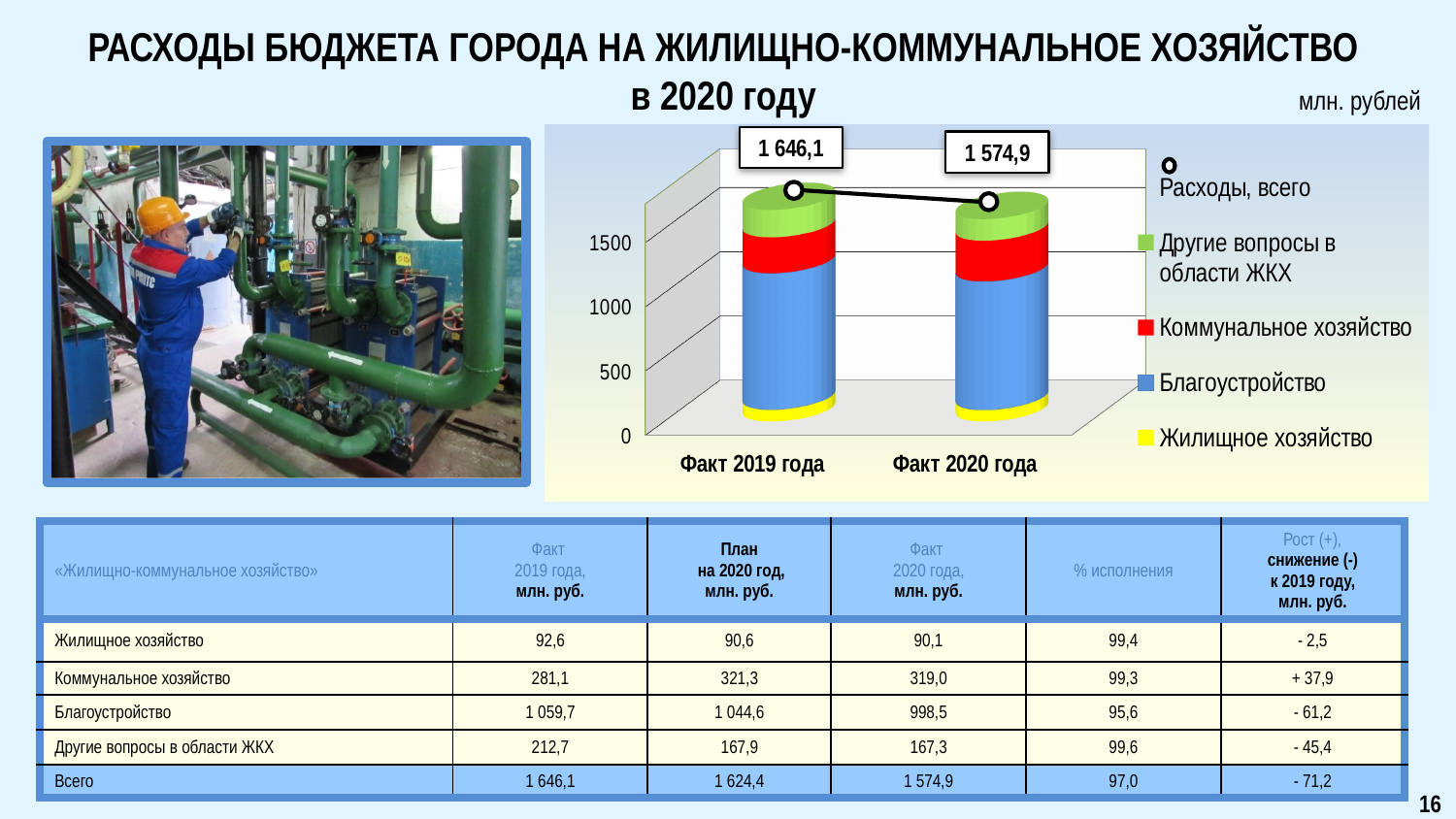
Which legend entry is shown in yellow? Жилищное хозяйство Do total expenditures rise or fall from Факт 2019 года to Факт 2020 года? fall Which colour represents Коммунальное хозяйство in the chart legend? red How many categories are shown on the x axis of the chart? 2 By how much does the total for Факт 2019 года exceed the total for Факт 2020 года? 71,2 What kind of chart is shown on the slide? bar chart Is the Благоустройство segment for Факт 2020 года greater or less than 500? greater What is the value of the 'Расходы, всего' data label for Факт 2019 года? 1 646,1 How many entries does the chart legend list? 5 What is the value of the 'Расходы, всего' data label for Факт 2020 года? 1 574,9 Which category has the higher total expenditure, Факт 2019 года or Факт 2020 года? Факт 2019 года Is the total for Факт 2020 года greater or less than 1500? greater